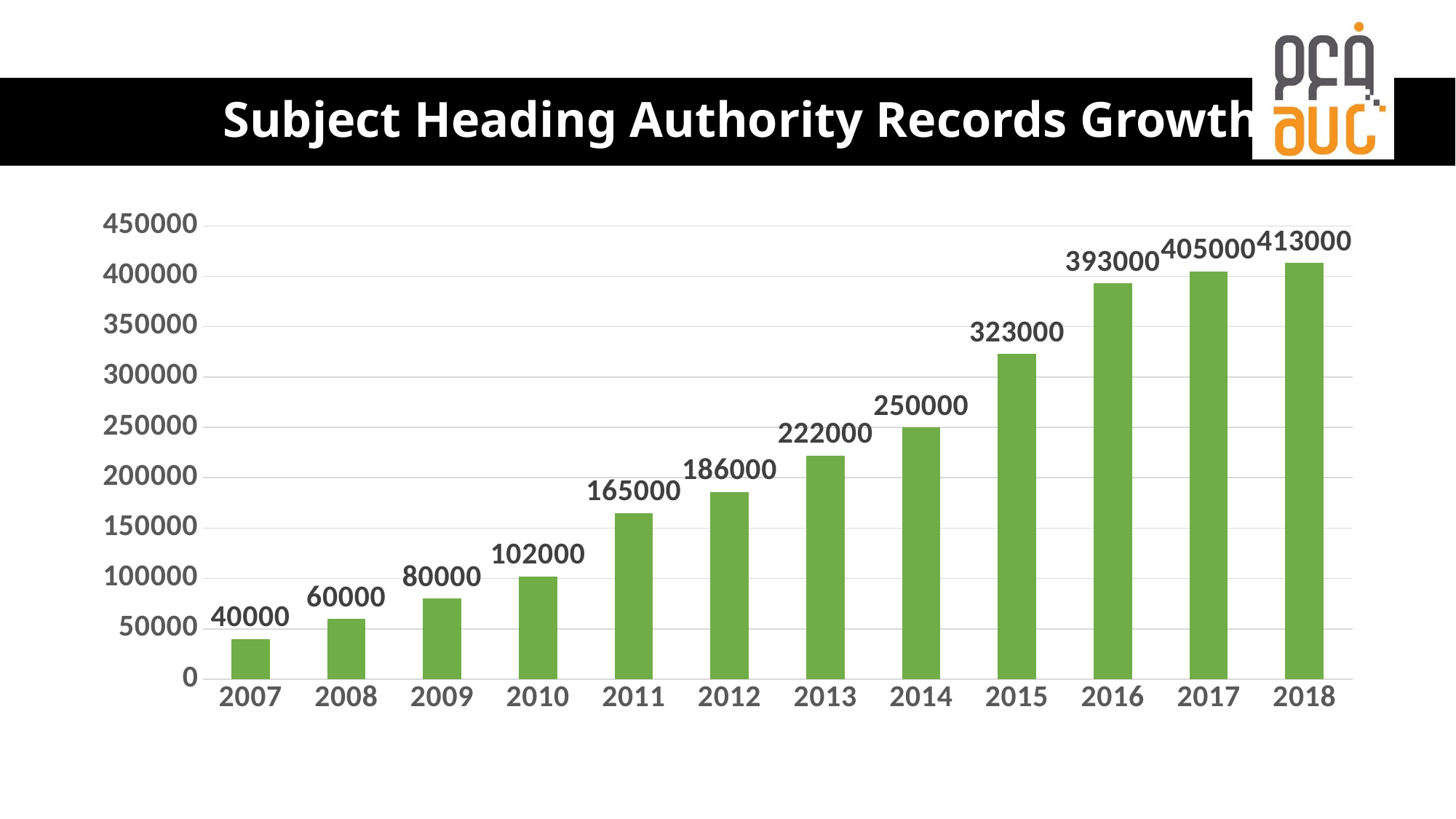
What is the difference between the values for 2016 and 2015? 70000 Which year has the lowest value? 2007 Do the values rise or fall from 2007 to 2018? rise What is the value for 2011? 165000 What is the value for 2007? 40000 What is the value for 2015? 323000 What is the difference between the values for 2018 and 2017? 8000 Is the value for 2014 greater or less than 200000? greater What kind of chart is shown on the slide? bar chart How many years are shown on the x axis? 12 Which is larger, the value for 2013 or the value for 2012? 2013 Which year has the highest value? 2018